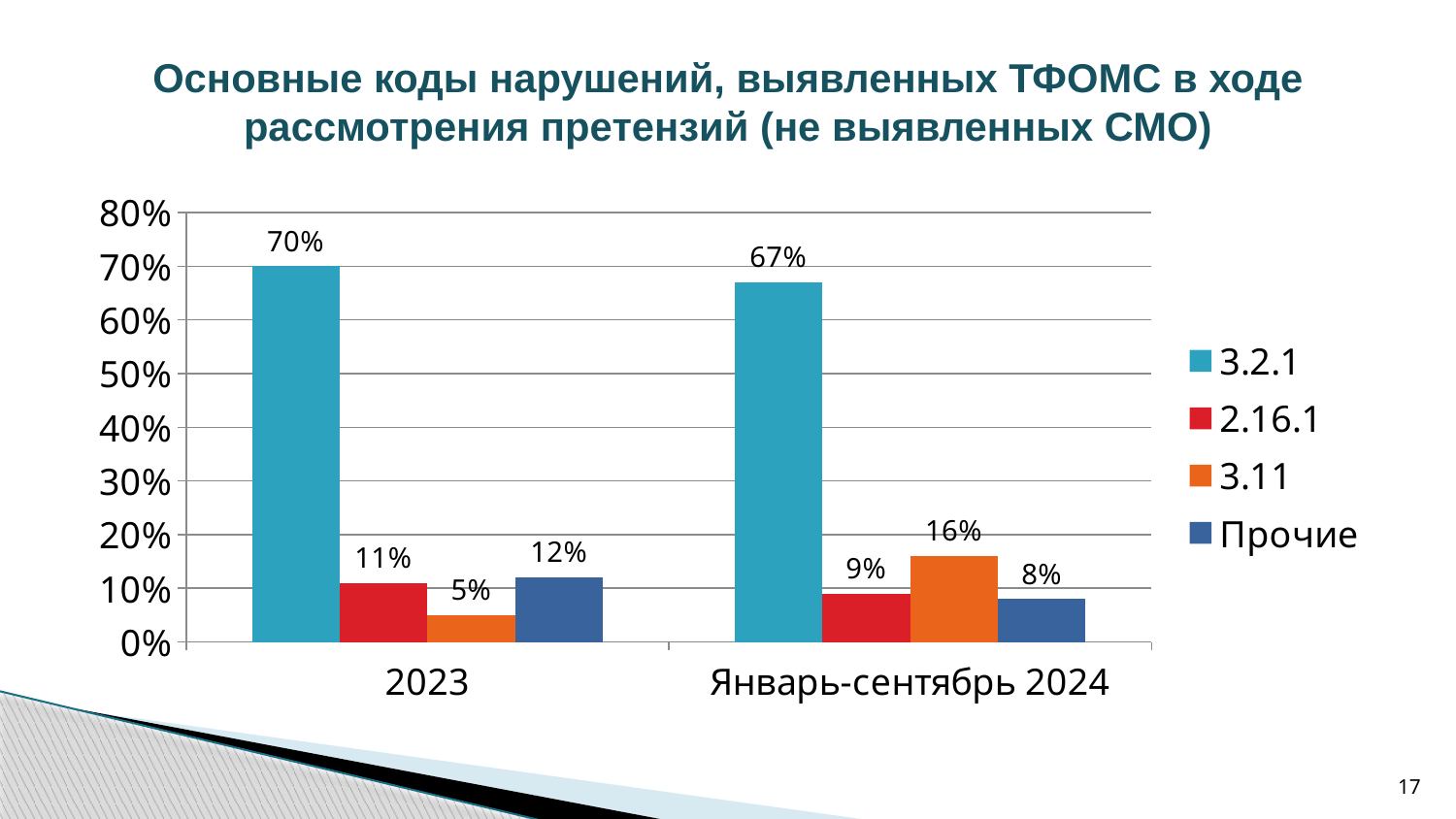
Which series has the highest value in Январь-сентябрь 2024? 3.2.1 Which is larger: the 3.11 value in 2023 or in Январь-сентябрь 2024? Январь-сентябрь 2024 How many series does the legend list? 4 What kind of chart is shown on the slide? Bar chart Does the value for series Прочие rise or fall from 2023 to Январь-сентябрь 2024? Fall What is the value for series 2.16.1 in Январь-сентябрь 2024? 9% What is the difference between the 3.2.1 values for 2023 and Январь-сентябрь 2024? 3% Which series has the lowest value in 2023? 3.11 How many categories are shown on the x axis? 2 What is the value for series 3.11 in Январь-сентябрь 2024? 16% What is the value for series Прочие in 2023? 12% What is the value for series 3.2.1 in 2023? 70%